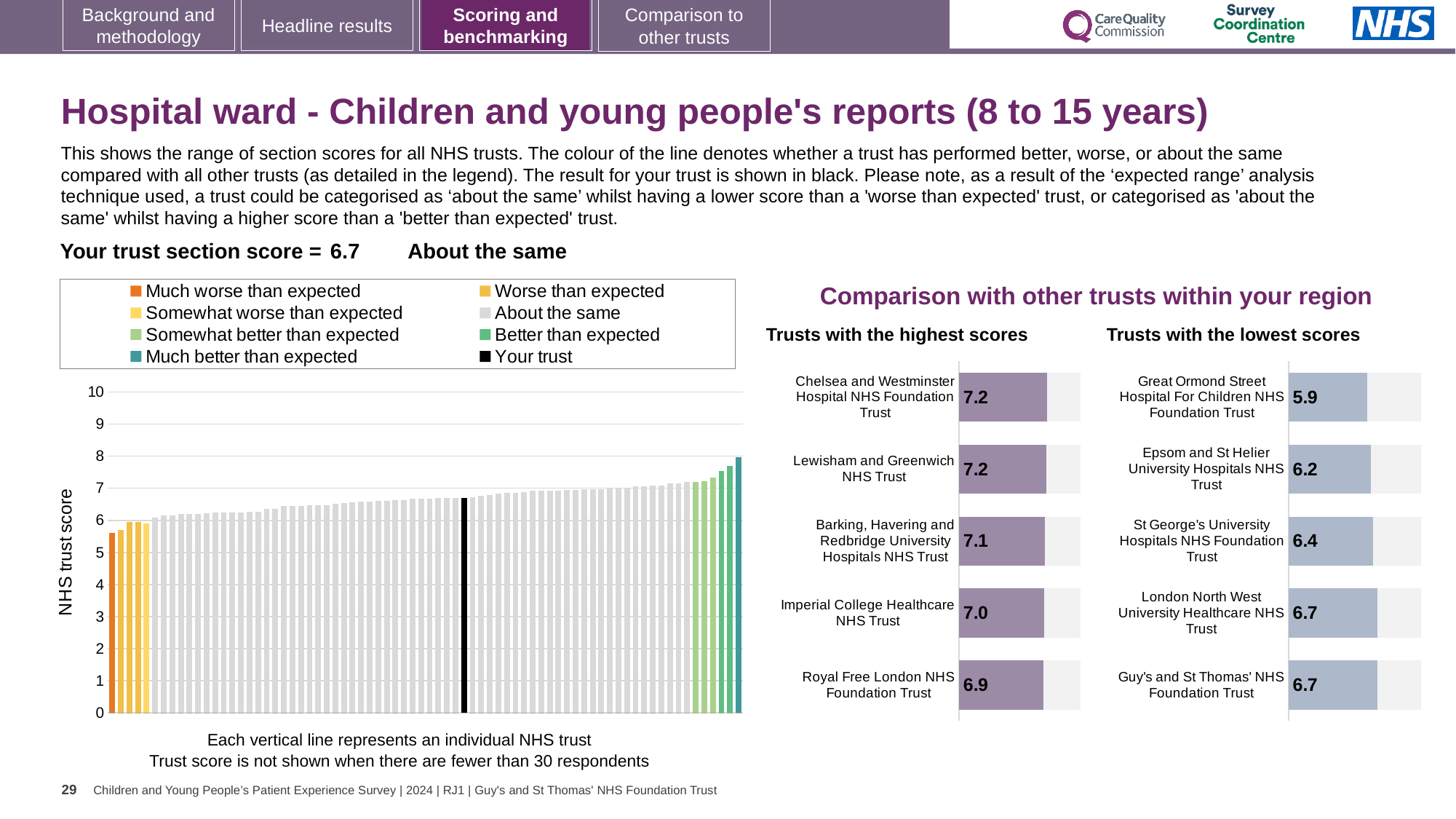
In the 'Trusts with the highest scores' chart, what is the score for Imperial College Healthcare NHS Trust? 7.0 In the 'Trusts with the lowest scores' chart, what is the score for Epsom and St Helier University Hospitals NHS Trust? 6.2 How many entries does the legend of the large chart on the left list? 8 In the 'Trusts with the highest scores' chart, which has the higher score: Barking, Havering and Redbridge University Hospitals NHS Trust or Imperial College Healthcare NHS Trust? Barking, Havering and Redbridge University Hospitals NHS Trust In the 'Trusts with the highest scores' chart, which trust has the lowest score? Royal Free London NHS Foundation Trust In the large chart on the left showing all NHS trusts, do the bar values rise or fall from left to right? rise In the 'Trusts with the lowest scores' chart, what is the difference between the scores of Guy's and St Thomas' NHS Foundation Trust and Great Ormond Street Hospital For Children NHS Foundation Trust? 0.8 In the large chart on the left showing all NHS trusts, is the value of the black bar (your trust) greater or less than 7? less In the 'Trusts with the lowest scores' chart, which trust has the lowest score? Great Ormond Street Hospital For Children NHS Foundation Trust In the 'Trusts with the lowest scores' chart, what is the score for Great Ormond Street Hospital For Children NHS Foundation Trust? 5.9 In the 'Trusts with the highest scores' chart, what is the difference between the scores of Chelsea and Westminster Hospital NHS Foundation Trust and Royal Free London NHS Foundation Trust? 0.3 How many trusts are shown in the 'Trusts with the lowest scores' chart? 5